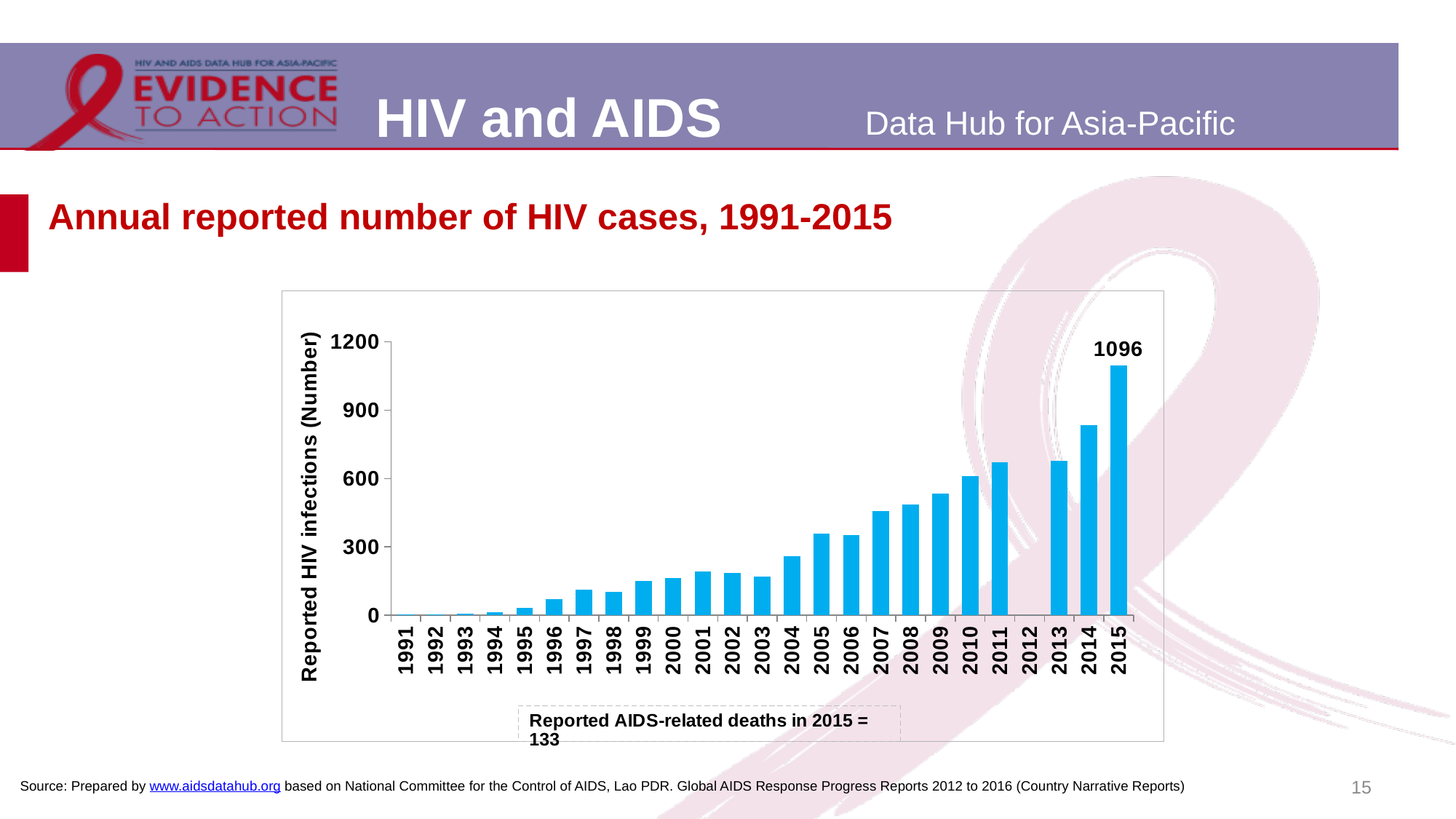
Is the value for 2011 greater or less than 600? greater Is the value for 2009 greater or less than 600? less Is the value for 2004 greater or less than 300? less What kind of chart is shown on the slide? bar chart Which year has the highest reported number of HIV cases? 2015 How many years are shown on the x axis of the chart? 25 Which year has the larger value, 2013 or 2014? 2014 According to the text box on the chart, how many AIDS-related deaths were reported in 2015? 133 What is the title of the y axis? Reported HIV infections (Number) Do the reported HIV cases generally rise or fall from 1991 to 2015? rise What is the reported number of HIV cases in 2015? 1096